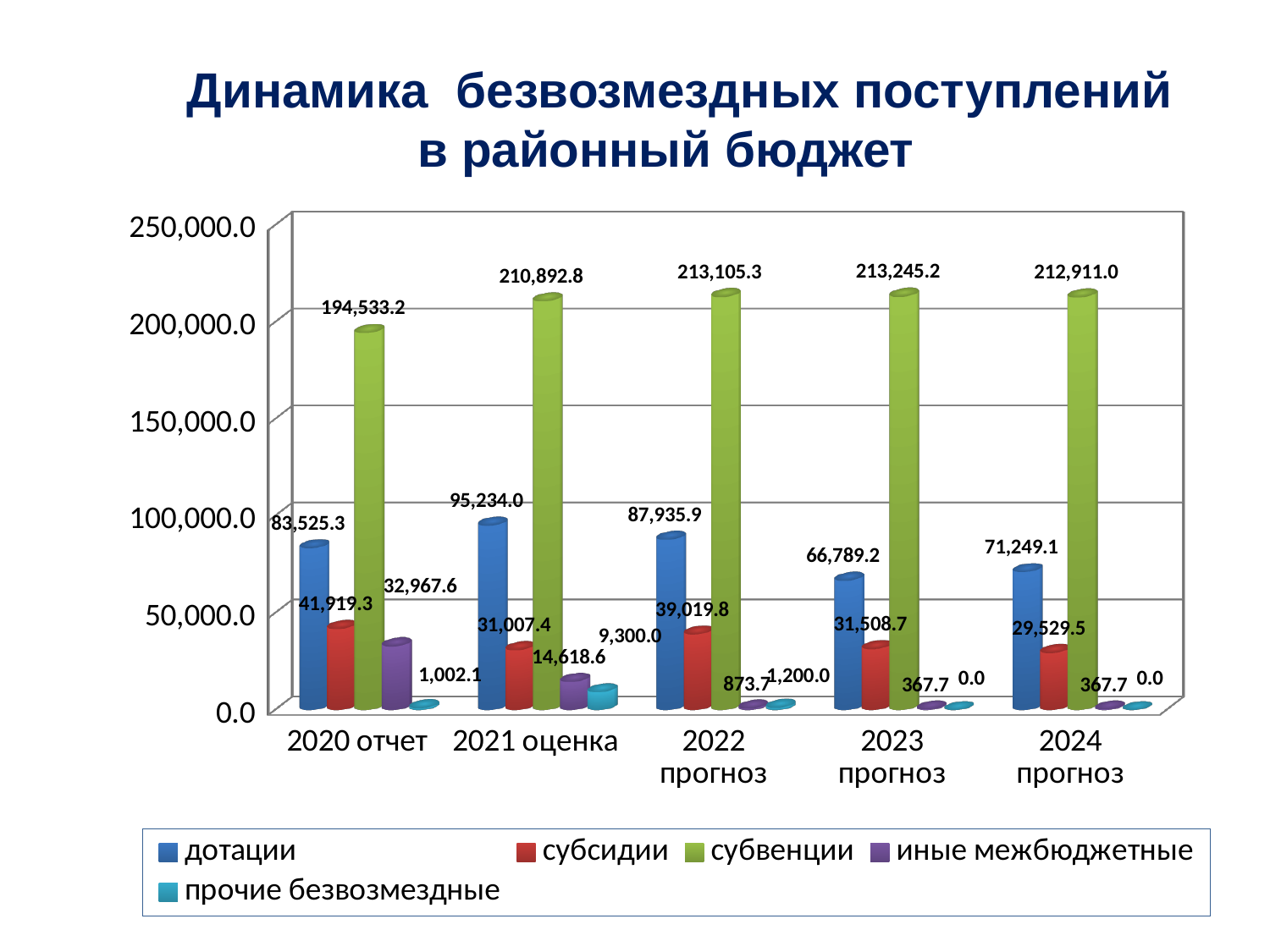
What is the value for дотации in 2021 оценка? 95,234.0 In which year is the value for дотации the lowest? 2023 прогноз By how much does the value for дотации in 2021 оценка exceed the value in 2020 отчет? 11,708.7 Is the value for субвенции in 2020 отчет greater or less than 200,000.0? less In which year is the value for субвенции the highest? 2023 прогноз How many series does the legend list? 5 What is the value for субвенции in 2022 прогноз? 213,105.3 What is the value for прочие безвозмездные in 2021 оценка? 9,300.0 Do the values for иные межбюджетные rise or fall from 2020 отчет to 2024 прогноз? fall What is the difference between the субвенции values for 2021 оценка and 2020 отчет? 16,359.6 Which is larger: субсидии in 2020 отчет or субсидии in 2022 прогноз? 2020 отчет How many year categories are shown on the x axis? 5